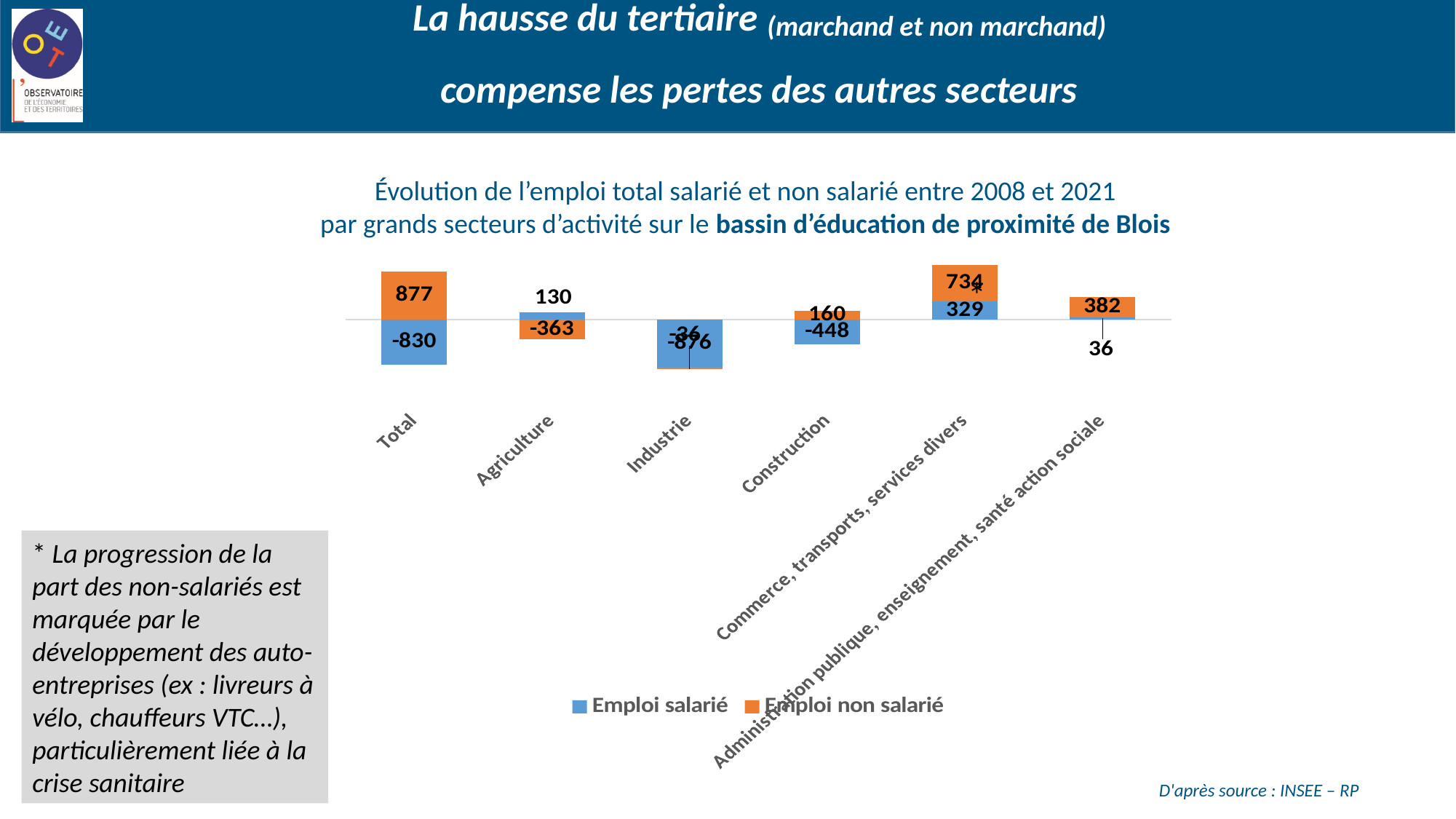
Which is larger: Emploi salarié for Commerce, transports, services divers or Emploi salarié for Administration publique, enseignement, santé action sociale? Commerce, transports, services divers What is the value of Emploi non salarié for Commerce, transports, services divers? 734 What is the value of Emploi non salarié for Agriculture? -363 How many categories are shown on the x axis? 6 What is the value of Emploi salarié for Administration publique, enseignement, santé action sociale? 36 What is the difference between Emploi non salarié and Emploi salarié for Commerce, transports, services divers? 405 Which category has the highest value for Emploi non salarié? Total What is the value of Emploi salarié for Total? -830 What kind of chart is shown on the slide? Bar chart What is the value of Emploi salarié for Construction? -448 What is the value of Emploi non salarié for Total? 877 How many series does the legend list? 2